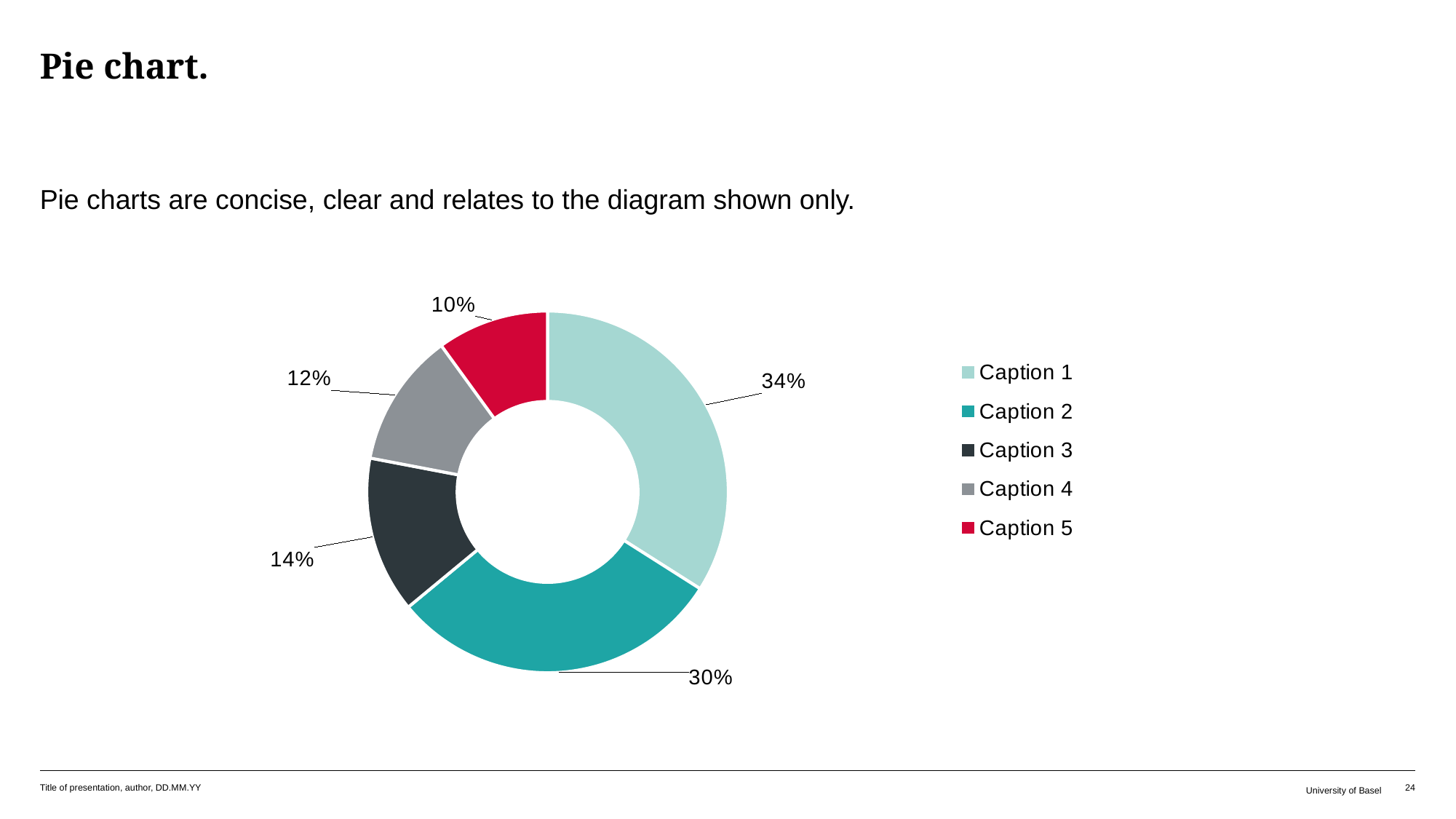
What percentage does Caption 2 account for in the pie chart? 30% What percentage does Caption 4 account for in the pie chart? 12% What percentage does Caption 1 account for in the pie chart? 34% What colour is the slice for Caption 5? Red How many slices does the pie chart have? 5 Which category has the smallest share of the pie chart? Caption 5 What kind of chart is shown on the slide? Pie chart What is the difference in percentage points between Caption 1 and Caption 2? 4 Which category has the largest share of the pie chart? Caption 1 What percentage does Caption 5 account for in the pie chart? 10% Which is larger, the share for Caption 3 or the share for Caption 4? Caption 3 What percentage does Caption 3 account for in the pie chart? 14%